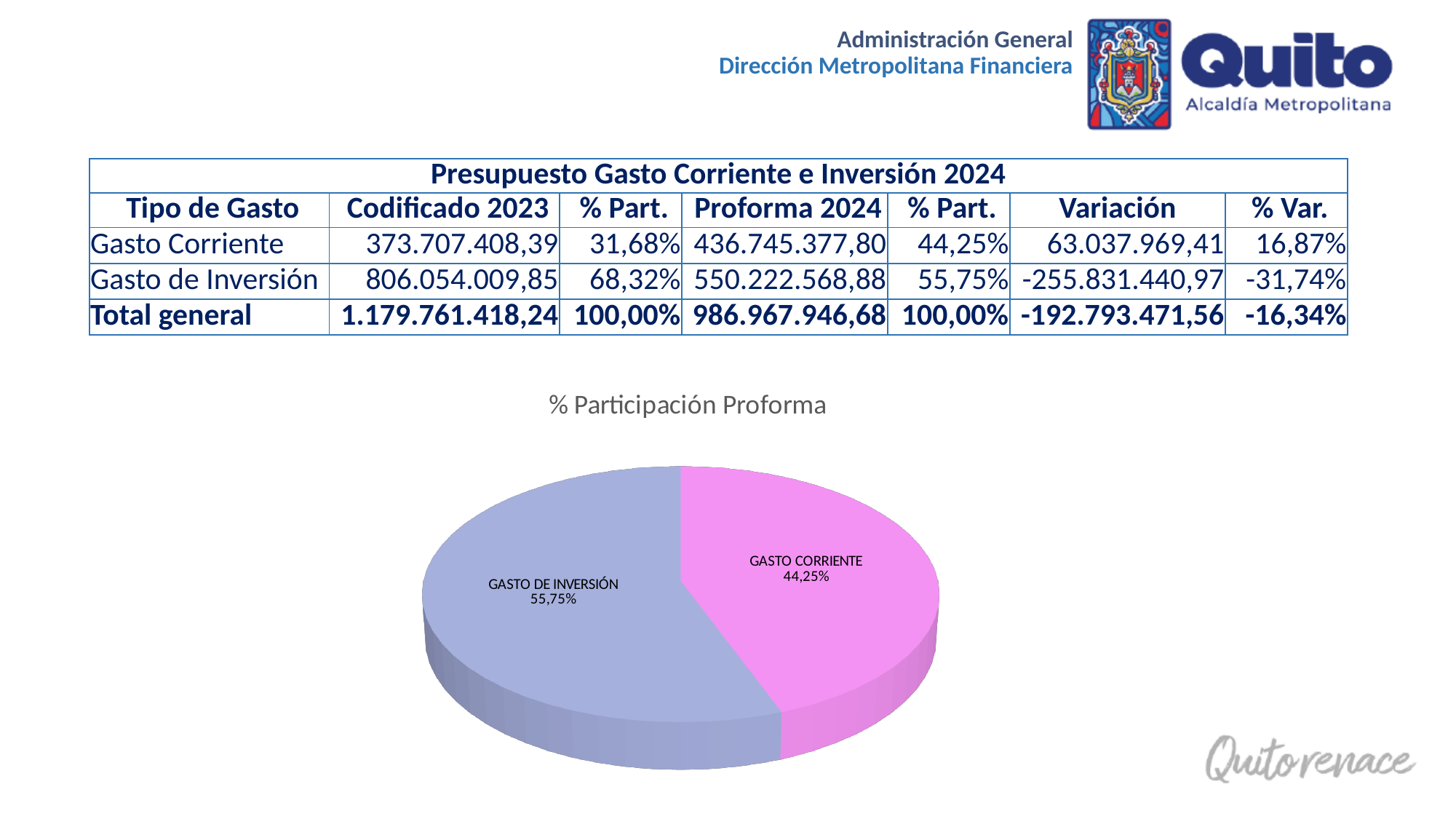
What type of chart is shown on the slide? pie chart Which slice of the pie is the largest? GASTO DE INVERSIÓN Is the share for GASTO CORRIENTE greater or less than 50%? less What is the total of the two slices shown in the pie chart? 100,00% How many slices does the pie chart have? 2 What is the difference in percentage points between the GASTO DE INVERSIÓN slice and the GASTO CORRIENTE slice? 11,50% Which is larger, the GASTO CORRIENTE slice or the GASTO DE INVERSIÓN slice? GASTO DE INVERSIÓN What share of the pie does GASTO CORRIENTE represent? 44,25% Which slice of the pie is the smallest? GASTO CORRIENTE What is the title of the chart? % Participación Proforma What share of the pie does GASTO DE INVERSIÓN represent? 55,75% What colour is the GASTO CORRIENTE slice? pink